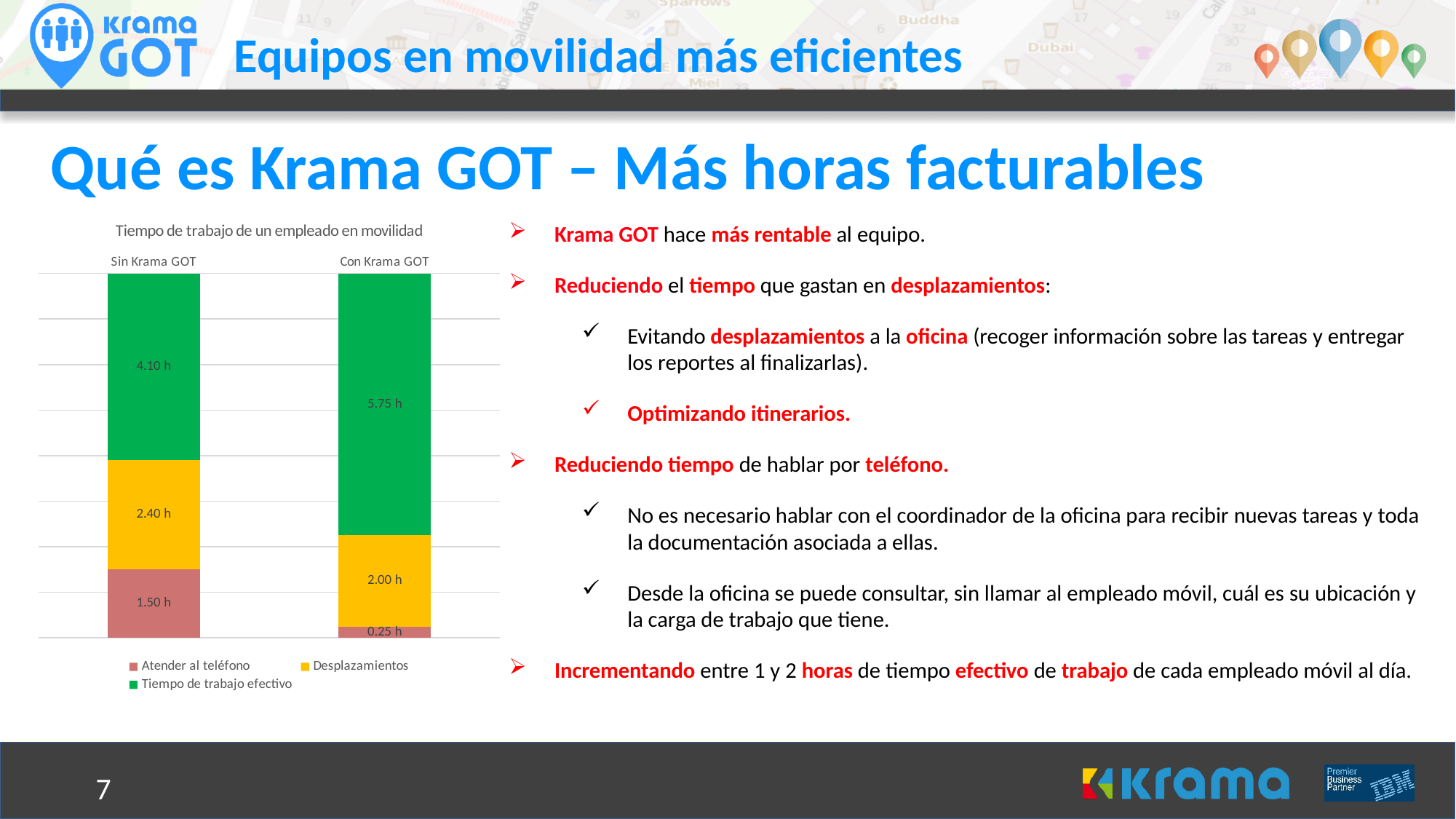
What is the value of Tiempo de trabajo efectivo for Con Krama GOT? 5.75 h Which category has the larger value for Atender al teléfono, Sin Krama GOT or Con Krama GOT? Sin Krama GOT How many series does the chart legend list? 3 What kind of chart is shown on the slide? Stacked bar chart What is the difference in Tiempo de trabajo efectivo between Con Krama GOT and Sin Krama GOT? 1.65 h How many bars (categories) are plotted in the chart? 2 What is the title of the chart? Tiempo de trabajo de un empleado en movilidad What is the value of Desplazamientos for Sin Krama GOT? 2.40 h What is the value of Tiempo de trabajo efectivo for Sin Krama GOT? 4.10 h What is the total of the stacked bar for Sin Krama GOT? 8.00 h Which colour represents Desplazamientos in the chart? Yellow What is the value of Atender al teléfono for Con Krama GOT? 0.25 h